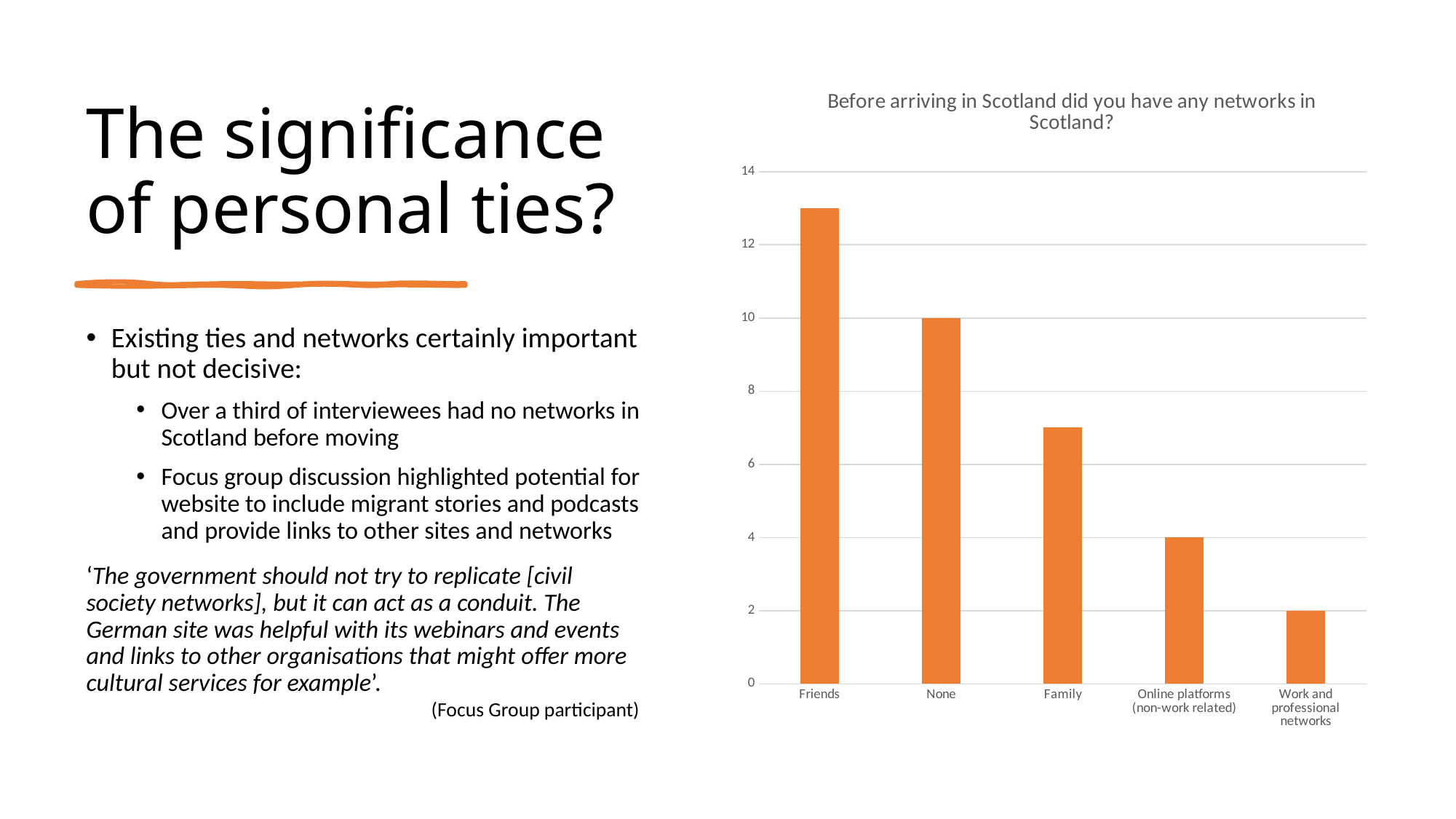
Is the value for Family greater or less than 8? less Is the value for Friends greater or less than 12? greater Do the bar values rise or fall from left to right across the x axis? fall What kind of chart is shown on the slide? bar chart What is the value for Work and professional networks? 2 How many categories are shown on the x axis of the chart? 5 Which is larger, the value for None or the value for Family? None What is the difference between the value for None and the value for Online platforms (non-work related)? 6 Which category has the lowest bar in the chart? Work and professional networks What is the value for None in the chart? 10 Which category has the highest bar in the chart? Friends What is the value for Online platforms (non-work related)? 4